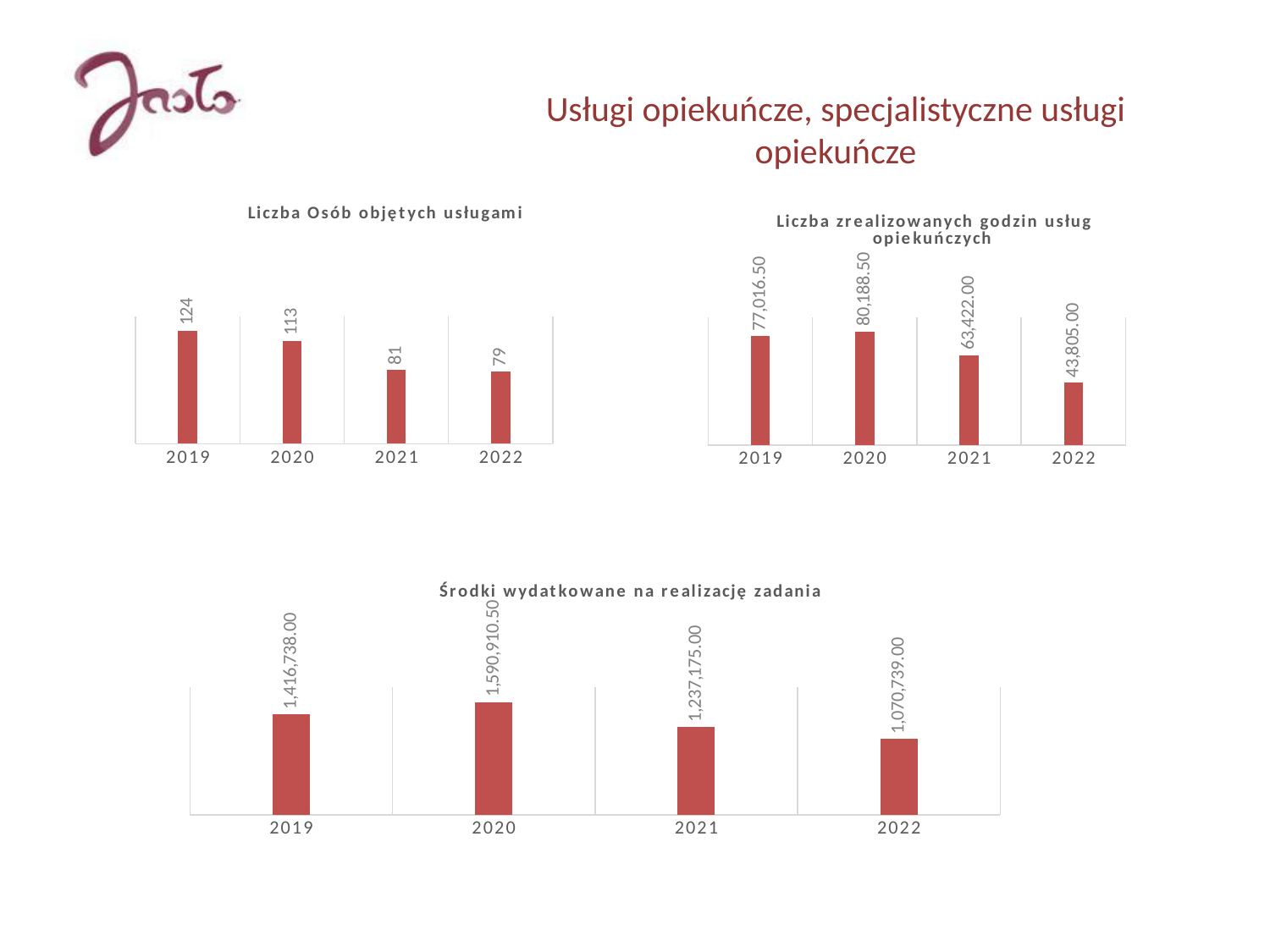
In the chart titled "Liczba Osób objętych usługami", which year has the lowest value? 2022 In the chart titled "Środki wydatkowane na realizację zadania", which year has the highest value? 2020 In the chart titled "Liczba zrealizowanych godzin usług opiekuńczych", which is larger, the value for 2019 or the value for 2021? 2019 In the chart titled "Liczba zrealizowanych godzin usług opiekuńczych", what is the value for 2020? 80,188.50 In the chart titled "Liczba Osób objętych usługami", what is the difference between the values for 2019 and 2020? 11 In the chart titled "Środki wydatkowane na realizację zadania", what is the value for 2021? 1,237,175.00 In the chart titled "Liczba Osób objętych usługami", do the values rise or fall from 2019 to 2022? fall In the chart titled "Liczba zrealizowanych godzin usług opiekuńczych", which year has the highest value? 2020 In the chart titled "Liczba zrealizowanych godzin usług opiekuńczych", what is the value for 2022? 43,805.00 In the chart titled "Środki wydatkowane na realizację zadania", how many years are shown on the x axis? 4 What kind of chart is the chart titled "Środki wydatkowane na realizację zadania"? bar chart In the chart titled "Liczba Osób objętych usługami", what is the value for 2019? 124